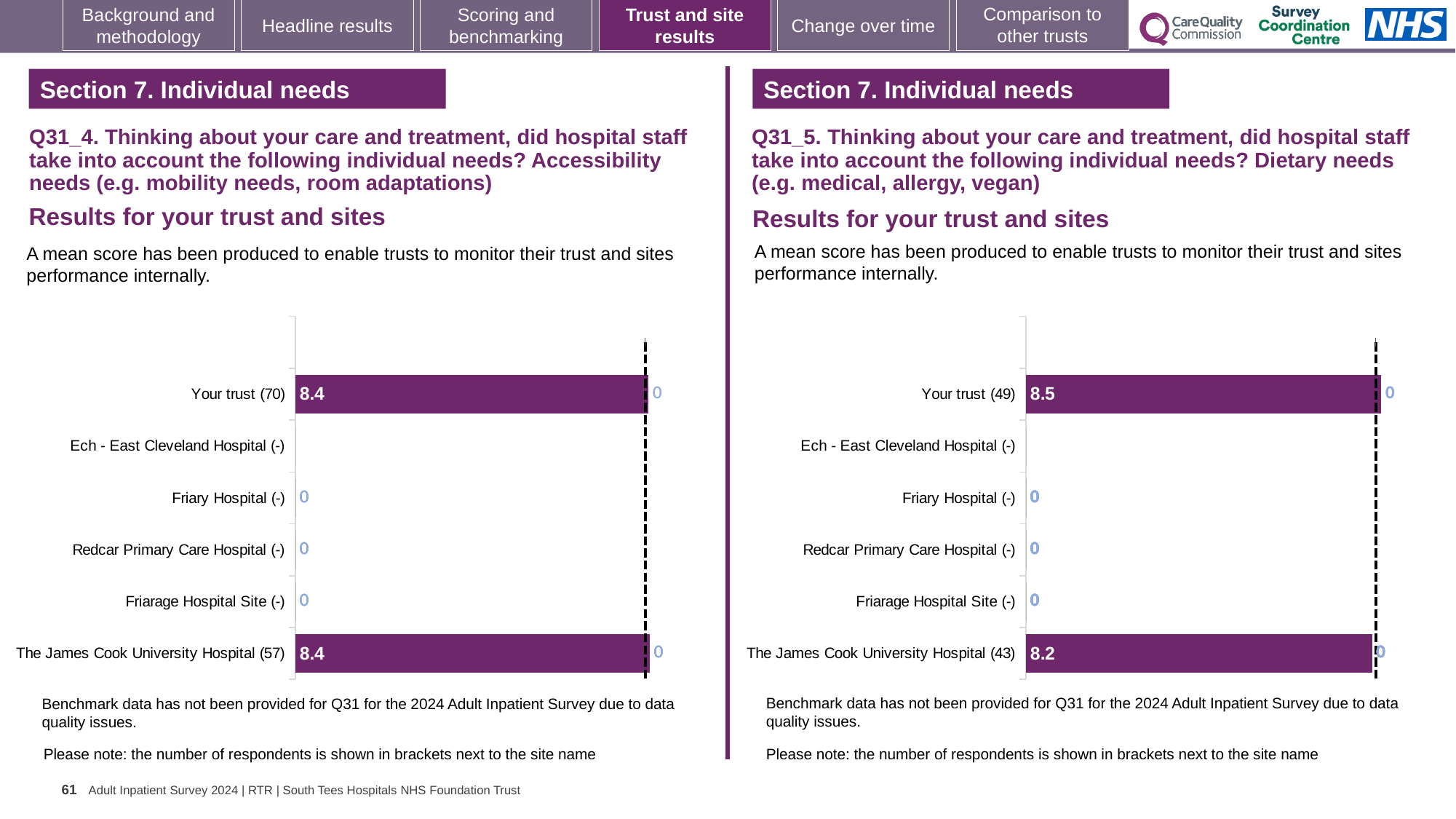
In the Q31_4 chart (Accessibility needs) on the left, how many respondents are shown in brackets for Your trust? 70 In the Q31_5 chart (Dietary needs) on the right, which is larger: the score for Your trust or the score for The James Cook University Hospital? Your trust In the Q31_4 chart (Accessibility needs) on the left, what is the mean score for The James Cook University Hospital? 8.4 How many site/trust categories are listed on the y axis of the Q31_4 chart on the left? 6 In the Q31_5 chart (Dietary needs) on the right, how many respondents are shown in brackets for The James Cook University Hospital? 43 In the Q31_4 chart (Accessibility needs) on the left, how many respondents are shown in brackets for The James Cook University Hospital? 57 In the Q31_5 chart (Dietary needs) on the right, what is the mean score for The James Cook University Hospital? 8.2 What kind of chart is used in the Q31_5 chart (Dietary needs) on the right? Bar chart In the Q31_5 chart (Dietary needs) on the right, what is the difference between the score for Your trust and the score for The James Cook University Hospital? 0.3 In the Q31_5 chart (Dietary needs) on the right, what is the mean score for Your trust? 8.5 In the Q31_4 chart (Accessibility needs) on the left, what is the mean score for Your trust? 8.4 In the Q31_5 chart (Dietary needs) on the right, how many respondents are shown in brackets for Your trust? 49